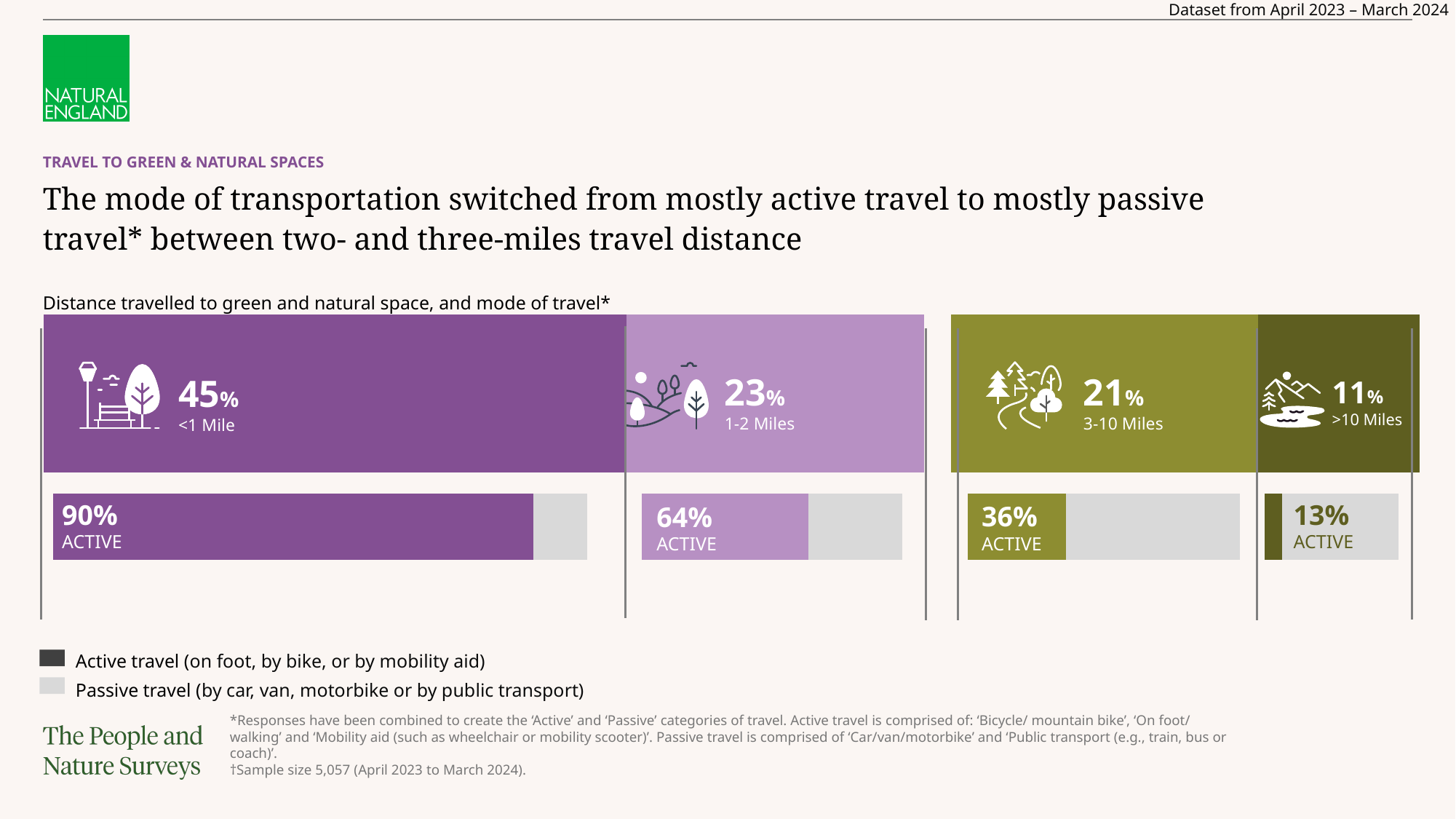
What percentage of visits were to green and natural spaces less than 1 mile away? 45% What share of travel was active for the 3-10 Miles distance band? 36% Which distance band has the highest share of active travel? <1 Mile How many travel modes does the legend list? 2 Which distance band has the lowest share of visits? >10 Miles Does the share of active travel rise or fall as travel distance increases? Fall What is the difference in active travel share between the <1 Mile and 1-2 Miles bands? 26% What percentage of visits were to spaces more than 10 miles away? 11% How many distance bands are shown in the chart? 4 What is the title of the chart? Distance travelled to green and natural space, and mode of travel* Which has a larger share of visits: 1-2 Miles or 3-10 Miles? 1-2 Miles What share of travel was active for the 1-2 Miles distance band? 64%